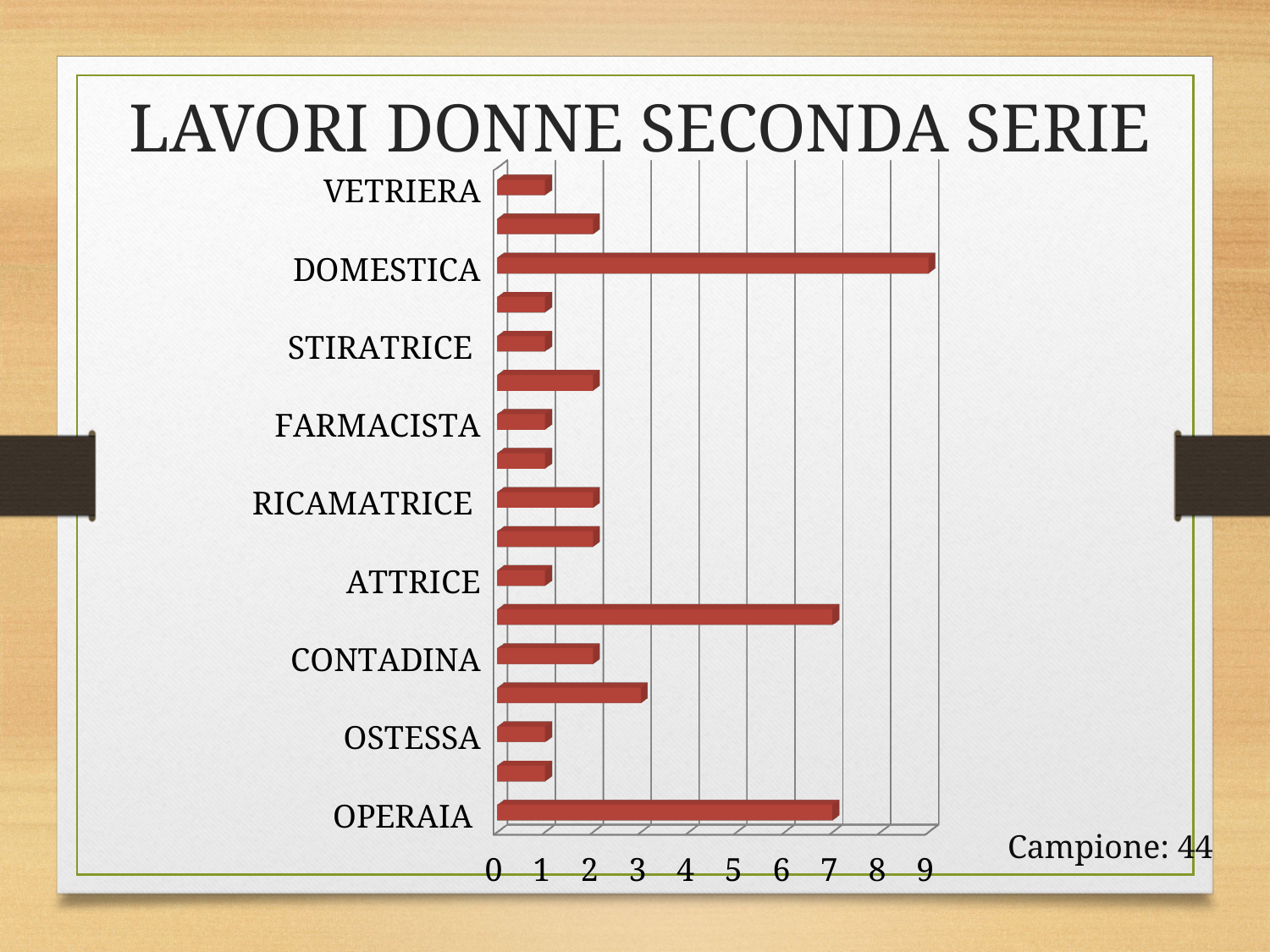
Is the value for DOMESTICA greater or less than 8? greater Is the value for VETRIERA greater or less than 2? less What sample size (Campione) is stated on the slide? 44 Which is larger, the value for DOMESTICA or the value for OPERAIA? DOMESTICA What is the title of the chart? LAVORI DONNE SECONDA SERIE Which is larger, the value for CONTADINA or the value for ATTRICE? CONTADINA Which labelled category has the longest bar? DOMESTICA What kind of chart is shown on the slide? bar chart Is the value for OPERAIA greater or less than 6? greater How many category labels are shown on the vertical axis? 9